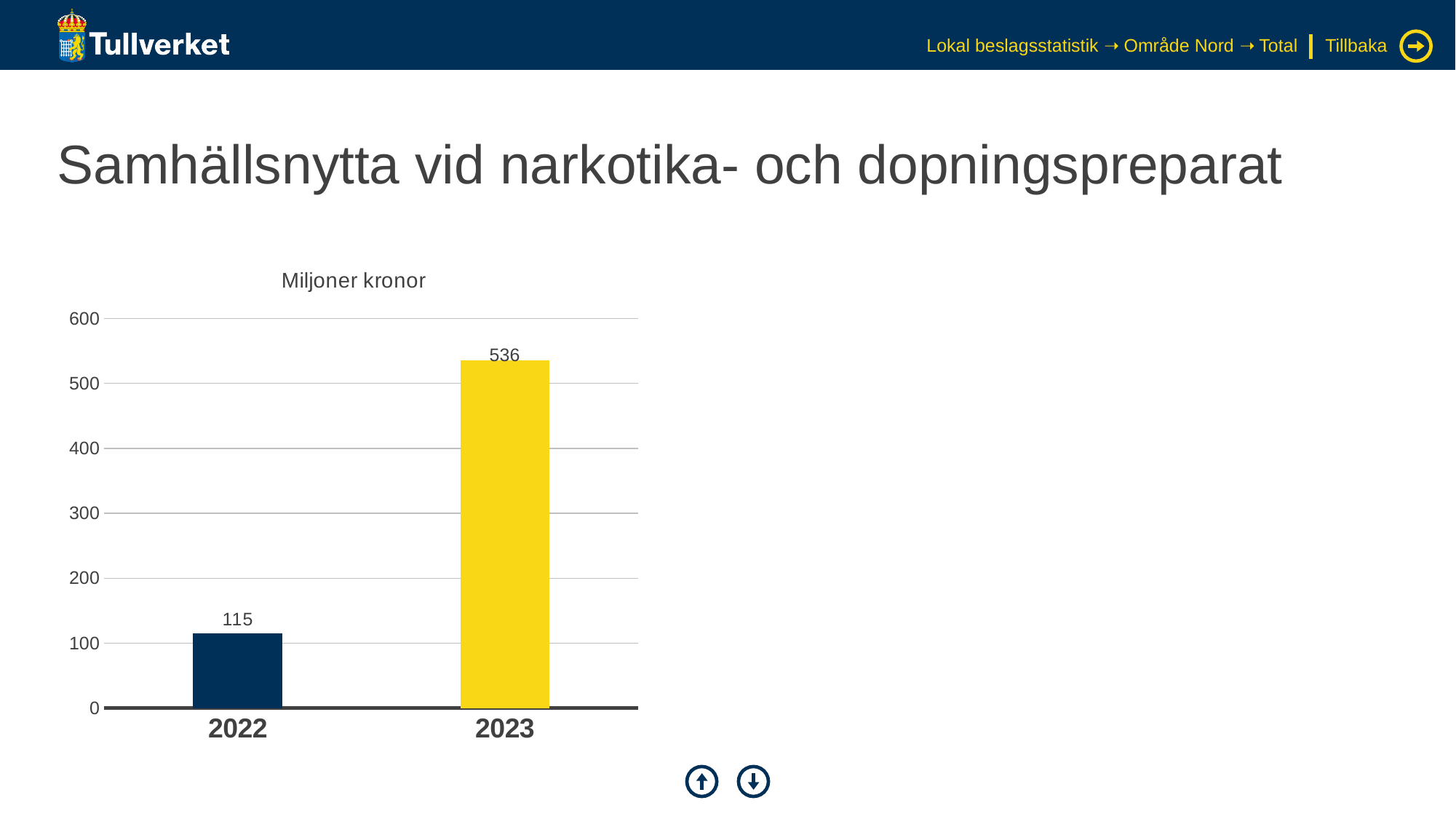
How many years are shown on the x axis? 2 What kind of chart is shown on the slide? bar chart What is the value for 2023? 536 Which is larger, the value for 2022 or the value for 2023? 2023 Is the value for 2023 greater or less than 500? greater Is the value for 2022 greater or less than 200? less Which year has the lowest value? 2022 What is the value for 2022? 115 What is the difference between the values for 2023 and 2022? 421 What unit label is shown above the chart? Miljoner kronor Do the values rise or fall from 2022 to 2023? rise Which year has the highest value? 2023